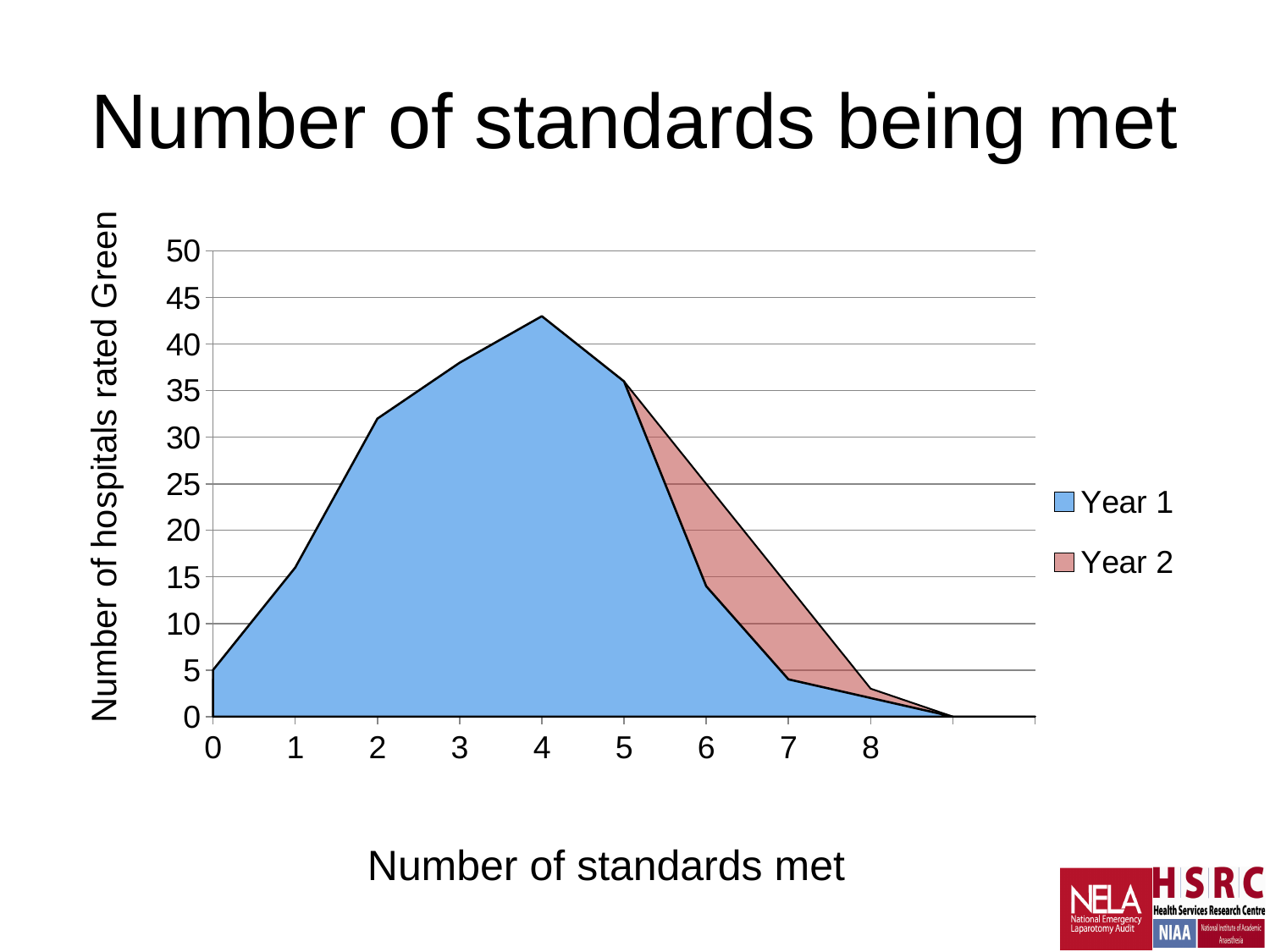
What are the two series named in the legend? Year 1 and Year 2 What is the title of the y axis? Number of hospitals rated Green How many series does the legend list? 2 Is the Year 1 value at 2 standards met greater or less than 30? greater What kind of chart is shown on the slide? Area chart Is the Year 2 value at 6 standards met greater or less than 20? greater At 6 standards met, which series has the larger value, Year 1 or Year 2? Year 2 Is the Year 1 value at 4 standards met greater or less than 40? greater Does the Year 1 series rise or fall between 4 and 7 standards met? Fall At which number of standards met does the Year 1 series reach its highest value? 4